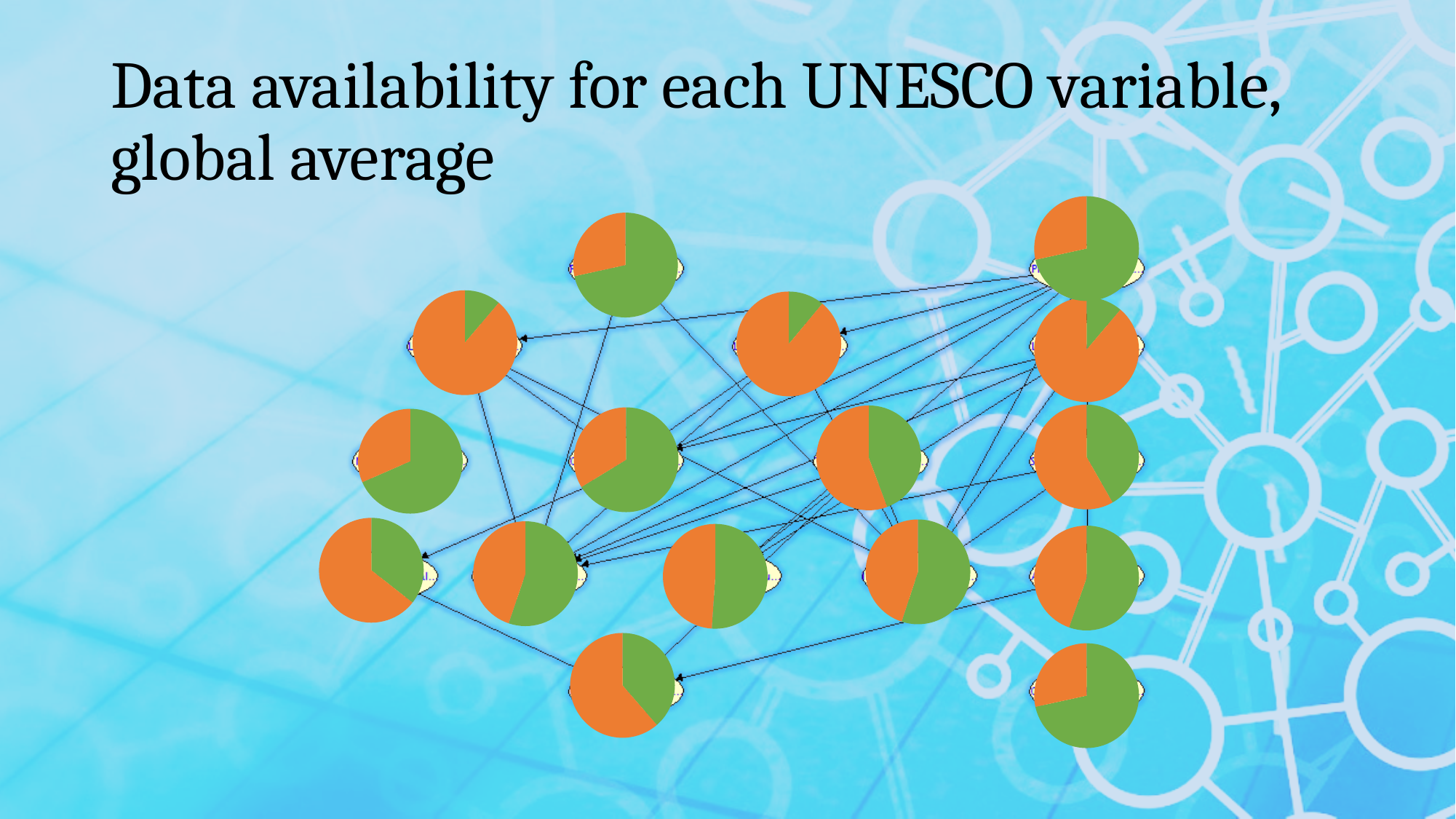
In the bottom pie chart of the right-hand column, which colour has the larger share? green What kind of charts are placed at the nodes of the network diagram? pie charts In the pie chart at the bottom centre of the diagram (the lowest pie in the middle), which colour has the larger share? orange In the pie chart at the top left of the diagram (the uppermost pie on the left side), which colour has the larger share? green Which two colours are used for the slices in the pie charts? orange and green How many pie charts are shown in the network diagram? 16 What is the title of the slide? Data availability for each UNESCO variable, global average